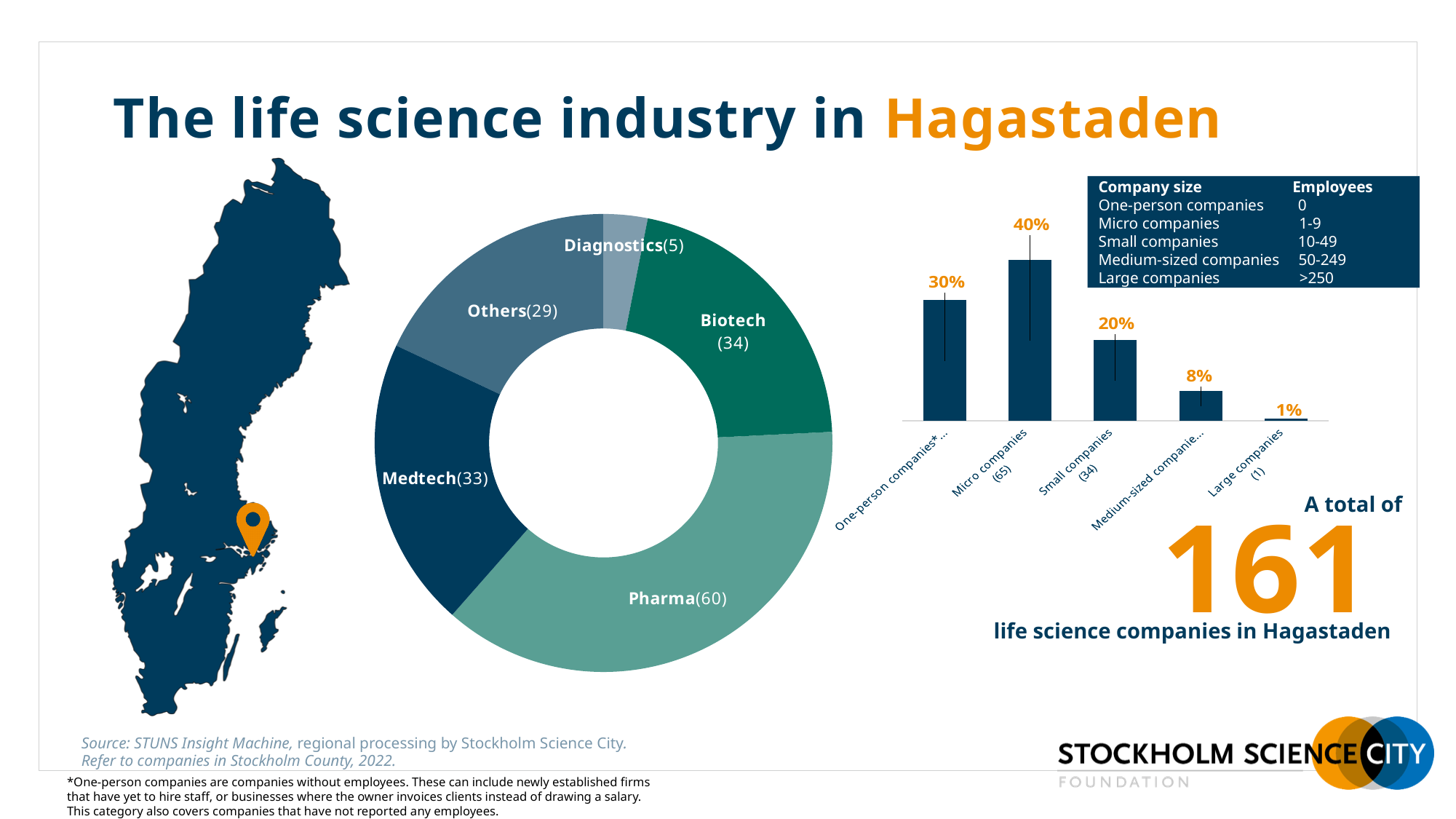
In the bar chart of company sizes, how many percentage points higher is the One-person companies bar than the Small companies bar? 10 percentage points In the donut chart, which sector has the smallest number of companies? Diagnostics In the donut chart, what is the difference between the number of Biotech companies and the number of Medtech companies? 1 In the bar chart of company sizes, which company size category has the lowest percentage? Large companies What kind of chart is the chart showing the sectors Biotech, Pharma, Medtech, Others and Diagnostics? Donut (pie) chart In the donut chart, how many companies are in the Pharma sector? 60 In the bar chart of company sizes, what percentage is shown for Micro companies? 40% In the donut chart, which has more companies, Medtech or Others? Medtech In the bar chart of company sizes, which company size category has the highest percentage? Micro companies In the donut chart, which sector has the largest number of companies? Pharma How many sectors are shown in the donut chart? 5 How many company size categories are shown in the bar chart? 5